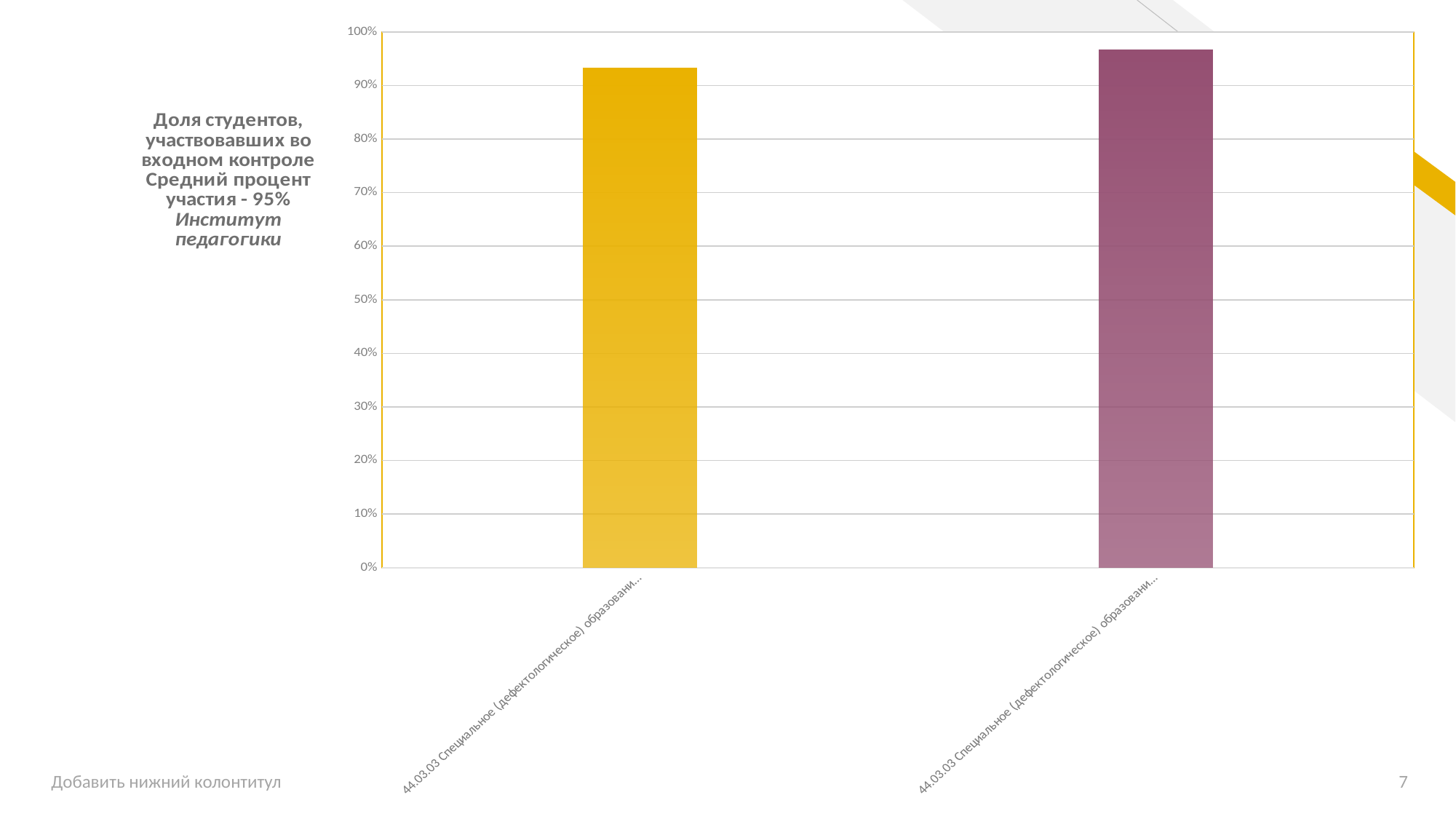
What kind of chart is shown on the slide? bar chart Which bar shows the lowest value? the left (yellow) bar Do the bar values rise or fall from left to right? rise What is the maximum value shown on the vertical axis? 100% Is the value of the left (yellow) bar greater or less than 90%? greater Is the value of the left (yellow) bar greater or less than 100%? less Which bar is taller, the left (yellow) bar or the right (purple) bar? the right (purple) bar How many bars are plotted in the chart? 2 Is the value of the right (purple) bar greater or less than 80%? greater According to the text on the slide, what is the average participation percentage (Средний процент участия)? 95%